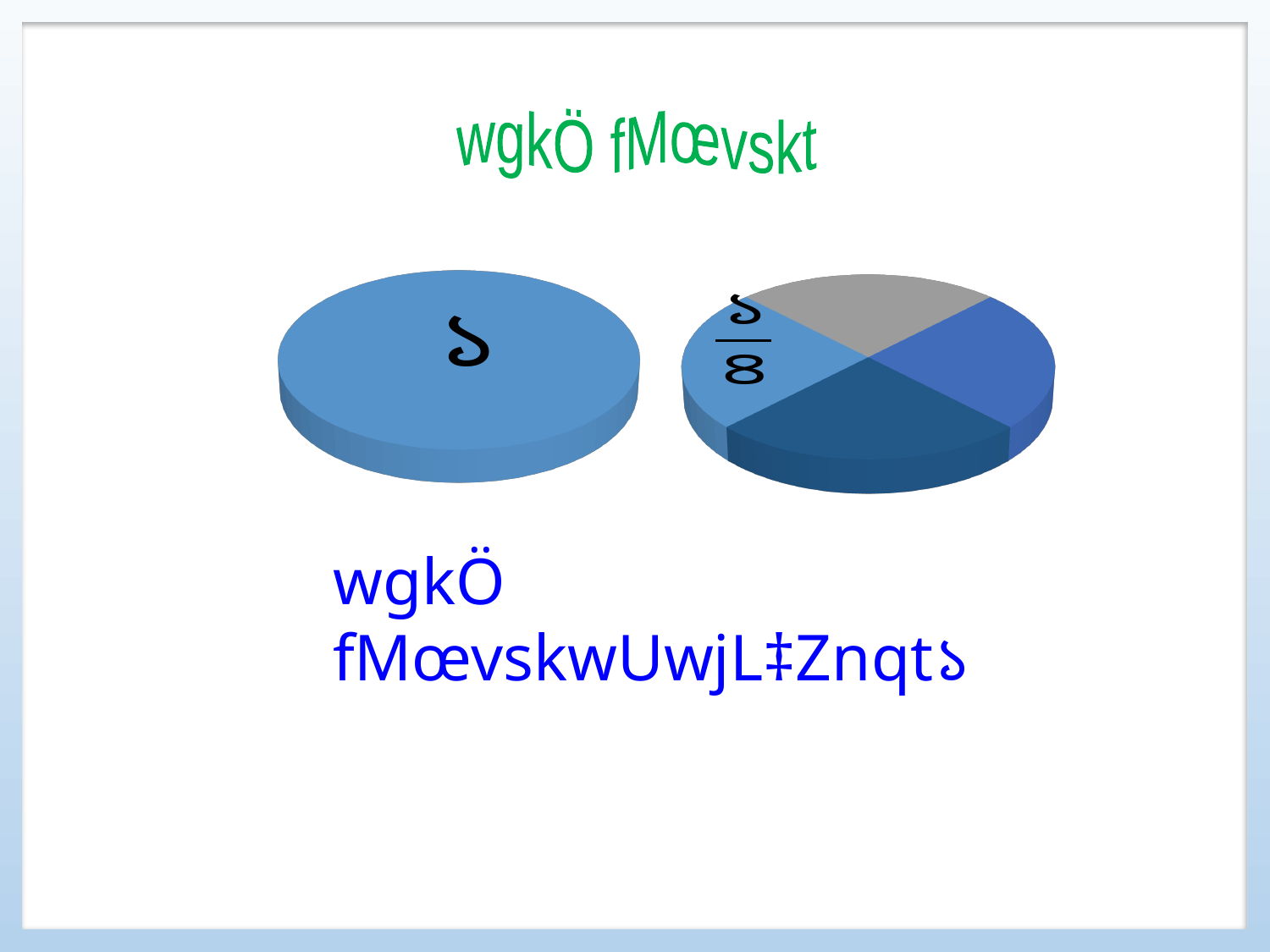
How many slices does the pie chart on the right of the slide have? 4 What label is printed on the pie chart on the left of the slide? ১ Are the slices of the pie chart on the right of the slide equal in size? yes How many slices of the pie chart on the right of the slide are coloured grey? 1 What share is printed on the labelled slice of the pie chart on the right of the slide? ১/৪ What kind of chart is the chart on the right of the slide? pie chart How many slices does the pie chart on the left of the slide have? 1 What kind of chart is the chart on the left of the slide? pie chart